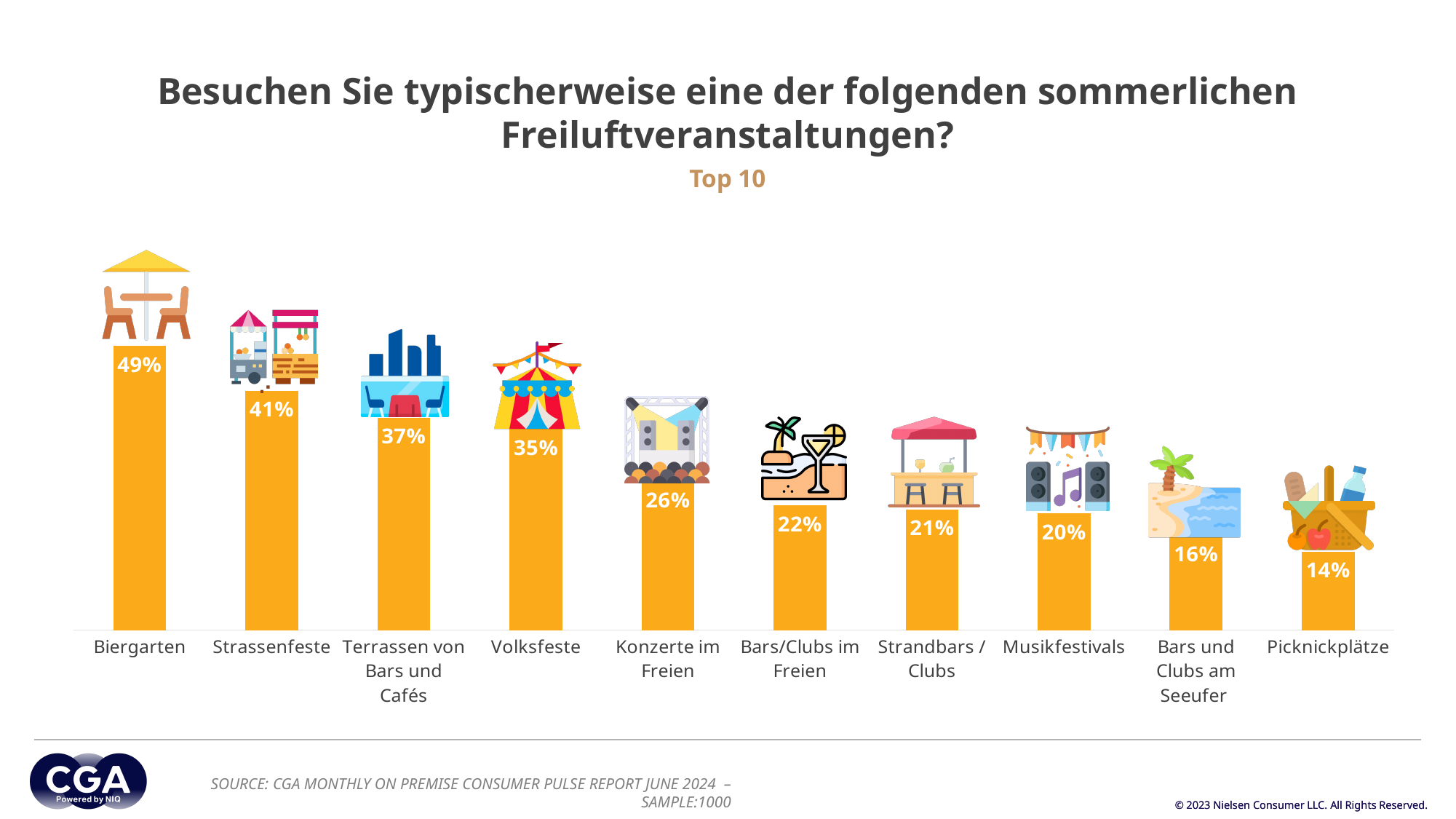
Which category has the lowest value? Picknickplätze Do the values rise or fall from left to right along the x axis? Fall Which category has the highest value? Biergarten What kind of chart is shown on the slide? Bar chart How many categories are shown in the chart? 10 Which is larger, the value for Bars/Clubs im Freien or the value for Bars und Clubs am Seeufer? Bars/Clubs im Freien What is the difference between the values for Volksfeste and Konzerte im Freien? 9% What is the value shown for Musikfestivals? 20% What percentage of respondents typically visit a Biergarten? 49% What is the difference between the values for Biergarten and Strassenfeste? 8% What is the subtitle shown below the chart title? Top 10 What is the value shown for Terrassen von Bars und Cafés? 37%